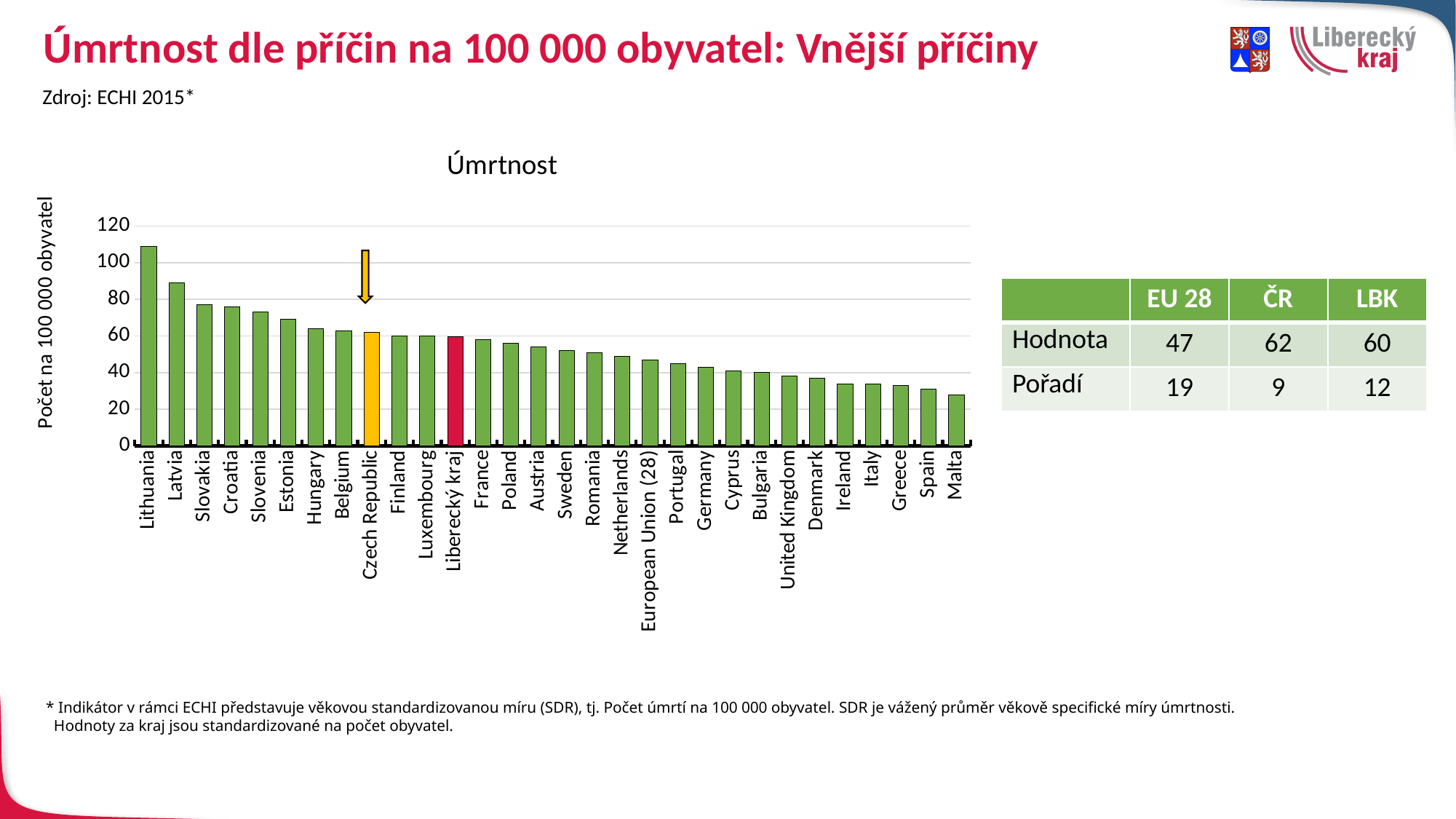
According to the table next to the chart, what is the difference between the value for ČR and the value for LBK? 2 Is the value for Estonia greater or less than 60? greater According to the table next to the chart, what is the value (Hodnota) for ČR? 62 How many categories (bars) are plotted in the chart? 30 Do the values rise or fall from left to right along the x axis? fall Is the value for Lithuania greater or less than 100? greater Which is larger, the value for Lithuania or the value for Latvia? Lithuania What is the title of the chart? Úmrtnost What kind of chart is shown on the slide? bar chart Which country has the highest value in the chart? Lithuania Is the value for Malta greater or less than 40? less Which country has the lowest value in the chart? Malta